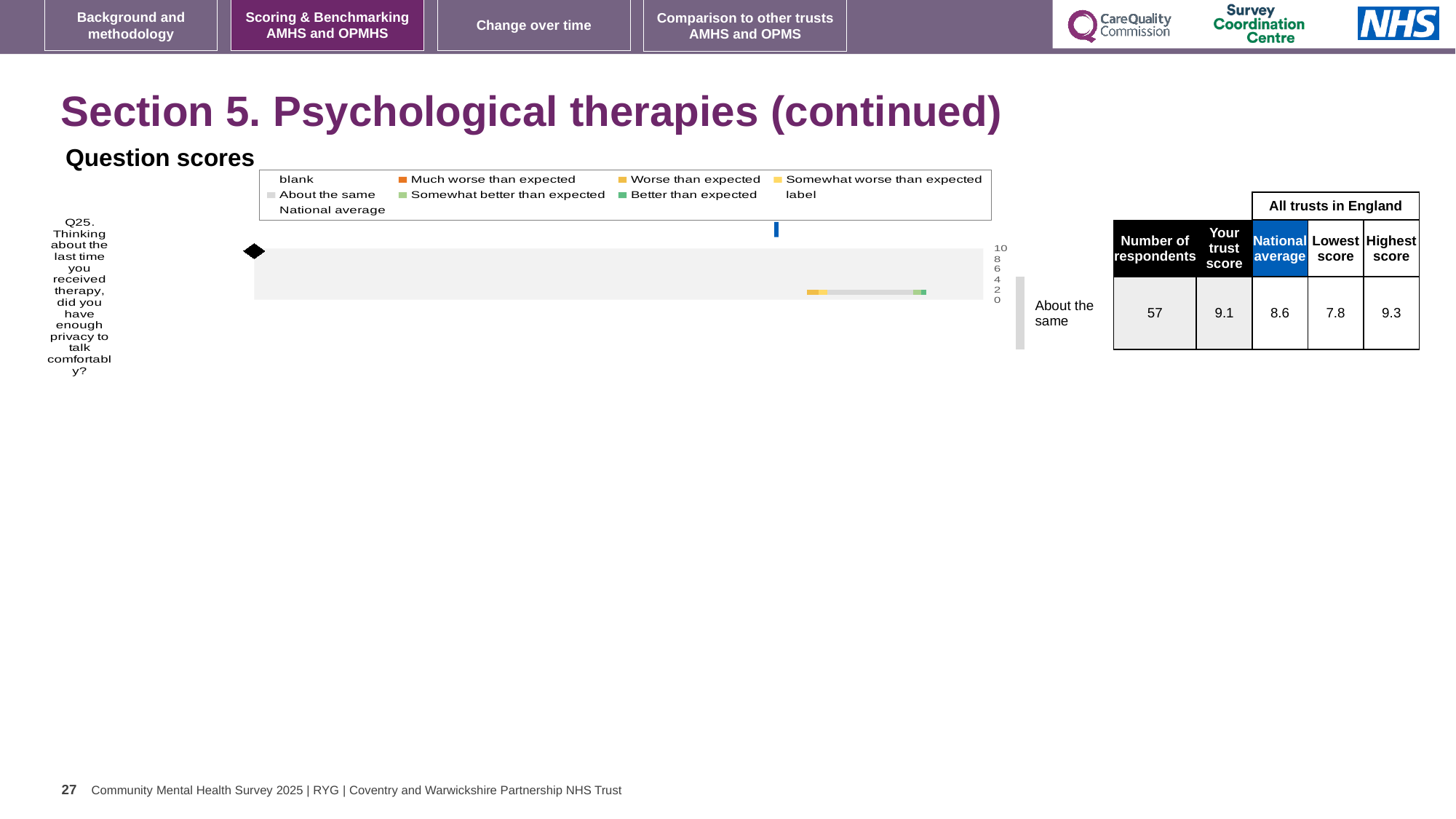
In the table beside the chart, what is the number of respondents for Q25? 57 In the table beside the chart, what is the 'Your trust score' for Q25? 9.1 How many entries does the legend of the Question scores chart list? 9 For Q25, what is the difference between the Highest score and the Lowest score among all trusts in England? 1.5 In the table beside the chart, what is the National average for Q25? 8.6 In the table beside the chart, what is the Lowest score among all trusts in England for Q25? 7.8 What kind of chart is shown under 'Question scores'? bar chart Which question number is plotted in the Question scores chart? Q25 In the table beside the chart, what is the Highest score among all trusts in England for Q25? 9.3 What benchmark category label is shown to the right of the bar for Q25? About the same For Q25, which is larger: the trust score or the National average? the trust score (9.1) How many survey questions are plotted in the Question scores chart? 1